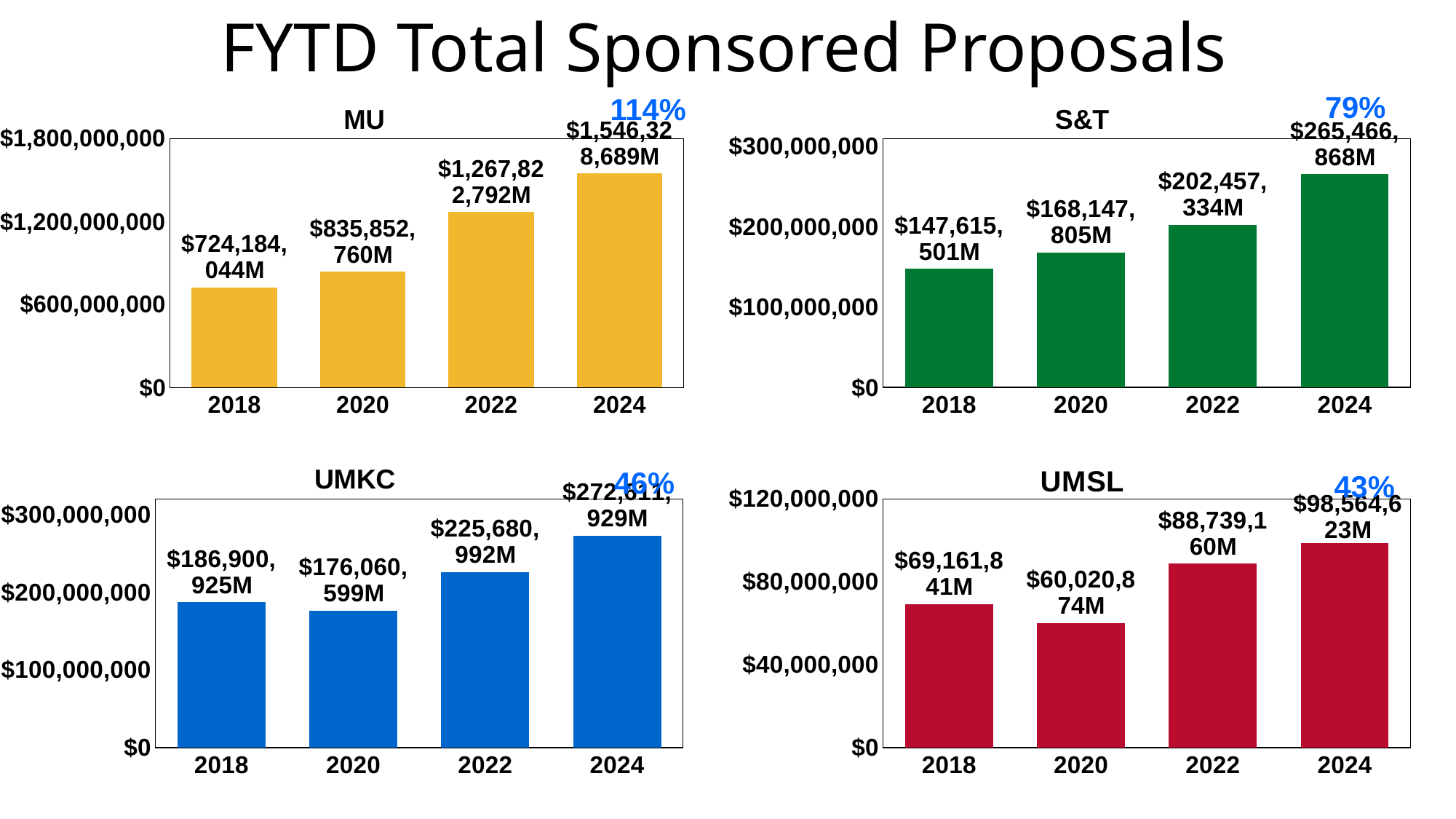
In the MU chart, which year has the highest value? 2024 In the UMKC chart, which is larger, the value for 2018 or the value for 2020? 2018 In the UMKC chart, is the value for 2024 greater or less than $200,000,000? greater In the UMKC chart, which year has the lowest value? 2020 In the UMSL chart, what is the difference between the 2022 and 2020 values? $28,718,286M In the S&T chart, what is the value for 2022? $202,457,334M In the S&T chart, what is the difference between the 2024 and 2022 values? $63,009,534M In the MU chart, what is the value for 2018? $724,184,044M What kind of chart is the S&T chart? bar chart How many bars are in the UMSL chart? 4 In the MU chart, do the values rise or fall from 2018 to 2024? rise In the UMSL chart, what is the value for 2020? $60,020,874M